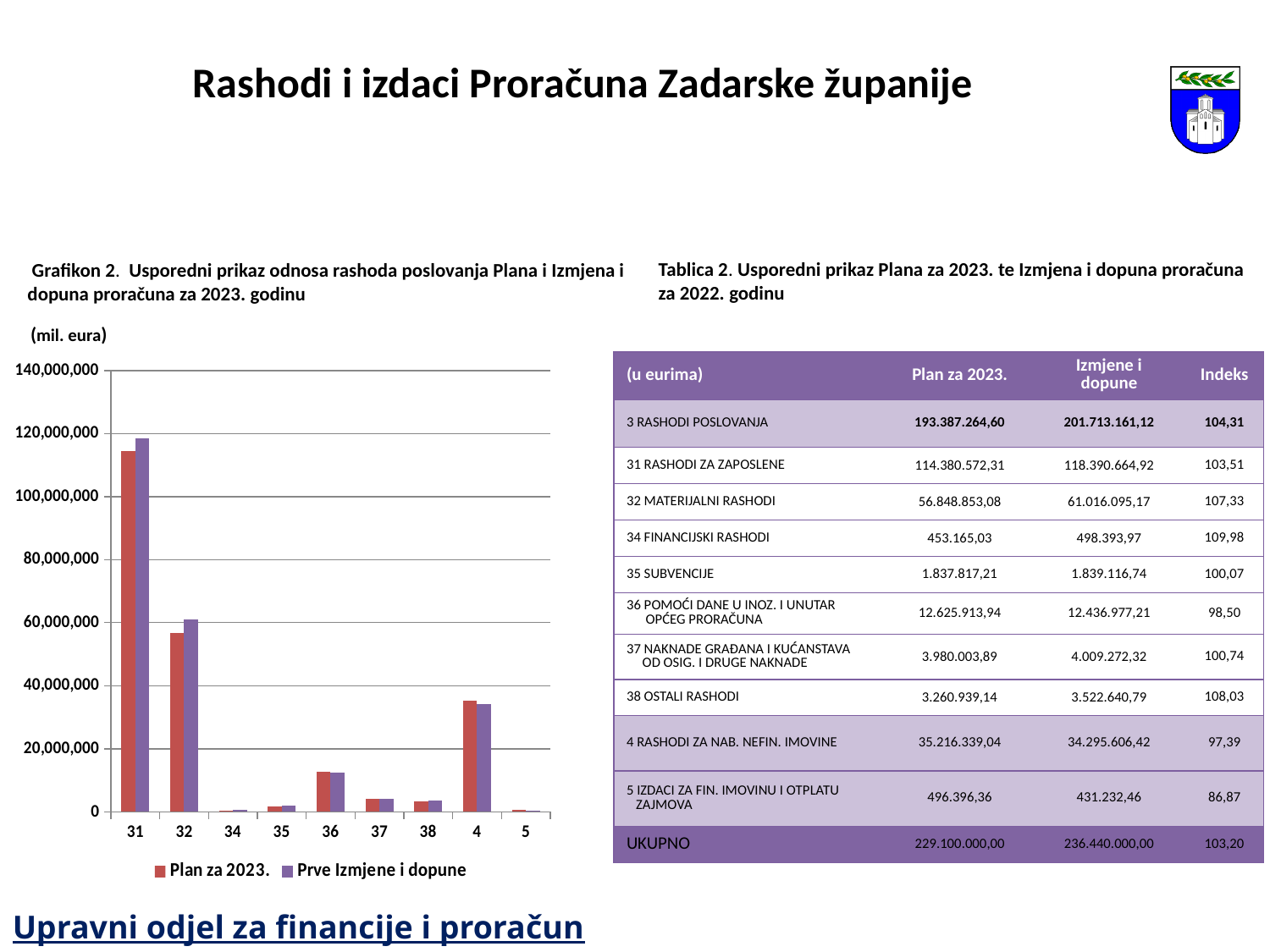
How many categories are shown on the x axis of the chart? 9 Is the value for category 31 in the 'Plan za 2023.' series greater or less than 100,000,000? greater Which category has the highest bars in the chart? 31 What are the two series named in the chart's legend? Plan za 2023. and Prve Izmjene i dopune Is the value for category 4 in the 'Plan za 2023.' series greater or less than 40,000,000? less How many series does the chart's legend list? 2 Is the value for category 32 in the 'Plan za 2023.' series greater or less than 60,000,000? less Which category has the larger 'Plan za 2023.' value, 32 or 4? 32 What kind of chart is shown on the slide? bar chart For category 32, which series has the larger value, 'Plan za 2023.' or 'Prve Izmjene i dopune'? Prve Izmjene i dopune What unit is indicated above the chart's y axis? (mil. eura)